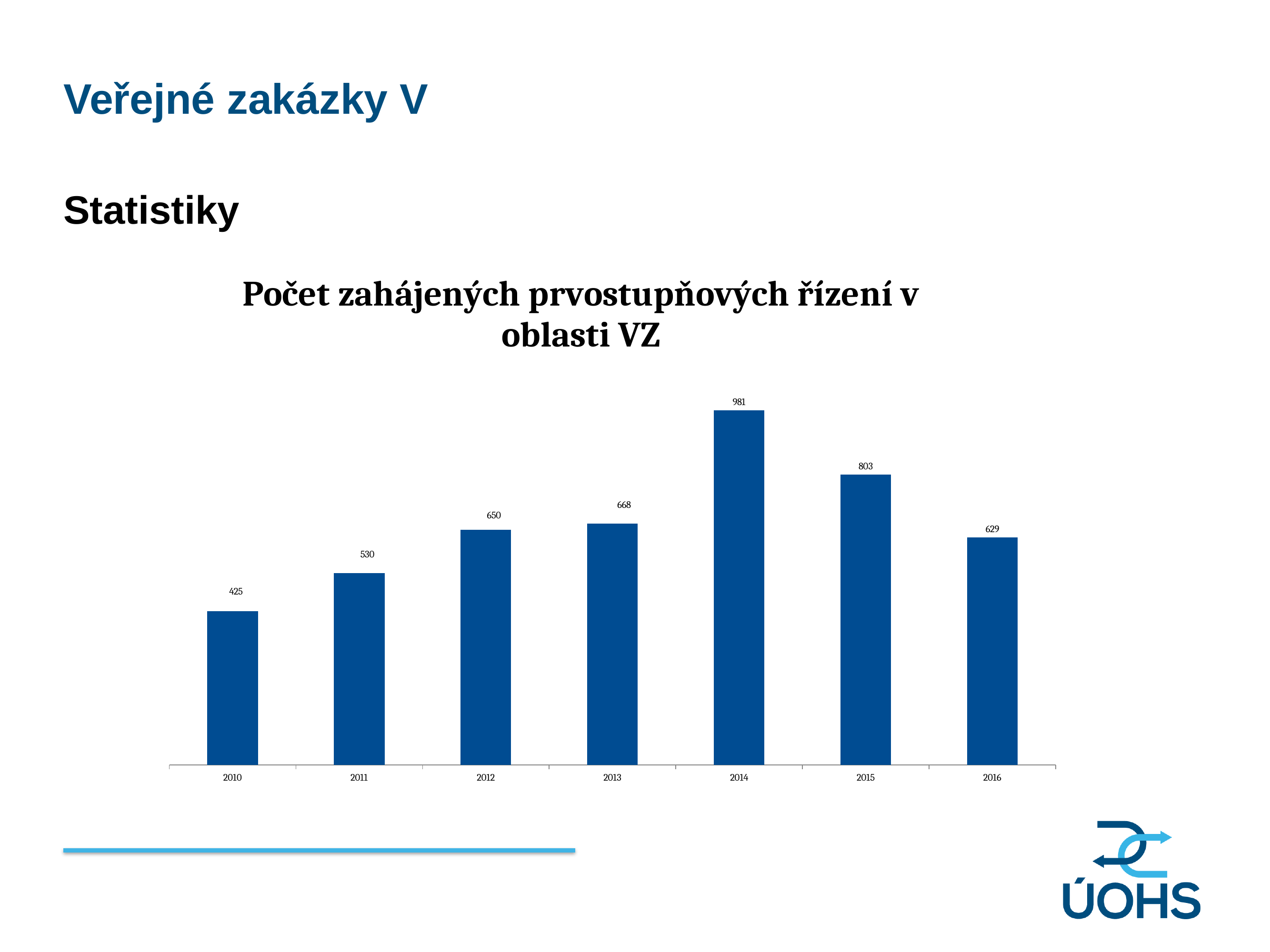
What is the difference between the values for 2014 and 2015? 178 What kind of chart is this? bar chart How many years are shown on the x axis? 7 What is the value for 2016? 629 What is the difference between the values for 2011 and 2010? 105 What is the value for 2010? 425 Which year has the highest value? 2014 What is the value for 2014? 981 Do the values rise or fall from 2010 to 2014? rise What is the title of the chart? Počet zahájených prvostupňových řízení v oblasti VZ Which is larger, the value for 2012 or the value for 2016? 2012 Which year has the lowest value? 2010